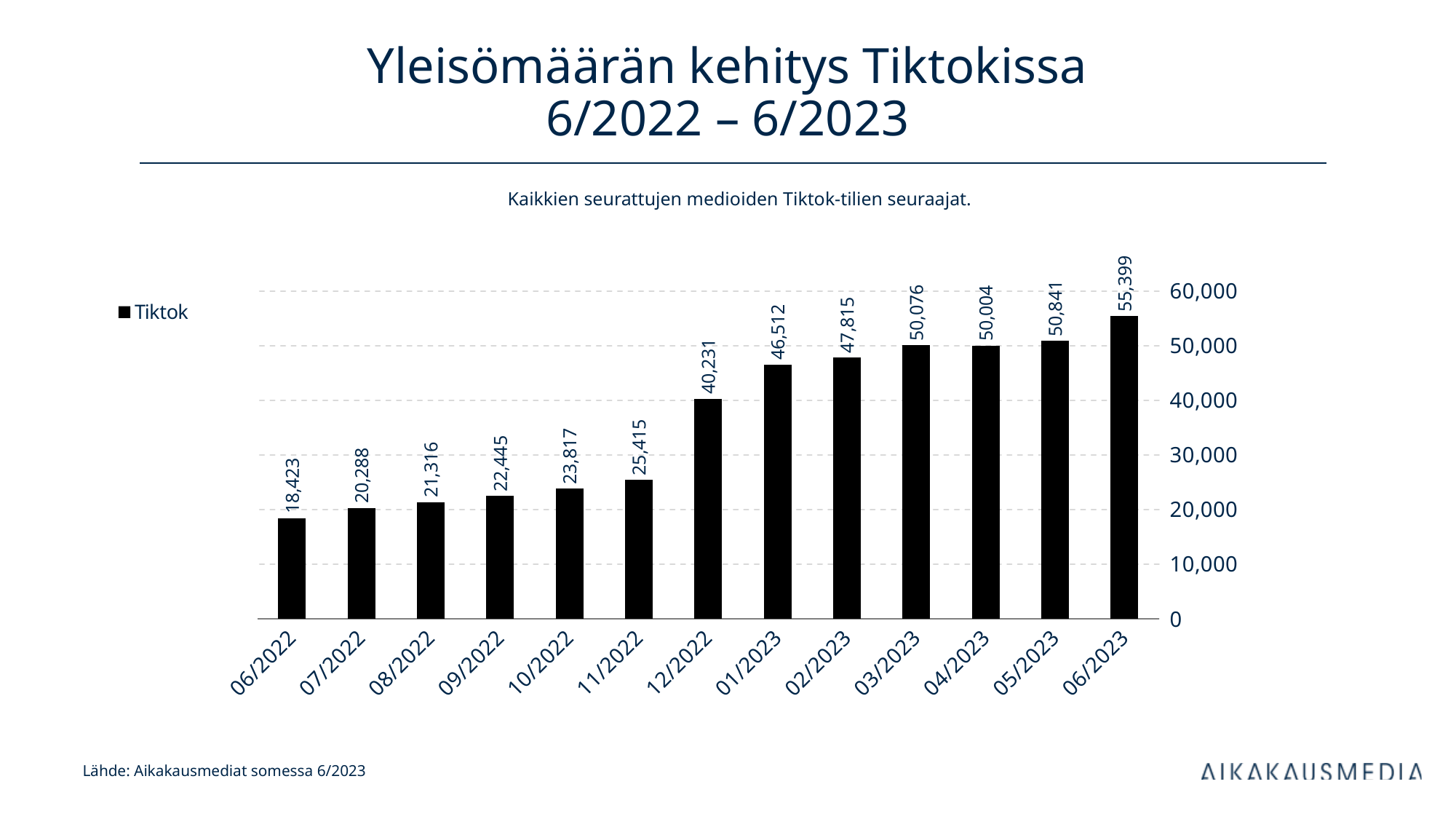
What is the value for 03/2023? 50,076 Do the values generally rise or fall from 06/2022 to 06/2023? rise Which month has the lowest value? 06/2022 What is the value for 12/2022? 40,231 How many months are shown on the x axis? 13 Is the value for 01/2023 greater or less than 40,000? greater Which month has the highest value? 06/2023 What is the value for 06/2022? 18,423 What kind of chart is shown on the slide? bar chart Which is larger, the value for 03/2023 or the value for 04/2023? 03/2023 What is the difference between the values for 12/2022 and 11/2022? 14,816 What is the difference between the values for 06/2023 and 06/2022? 36,976